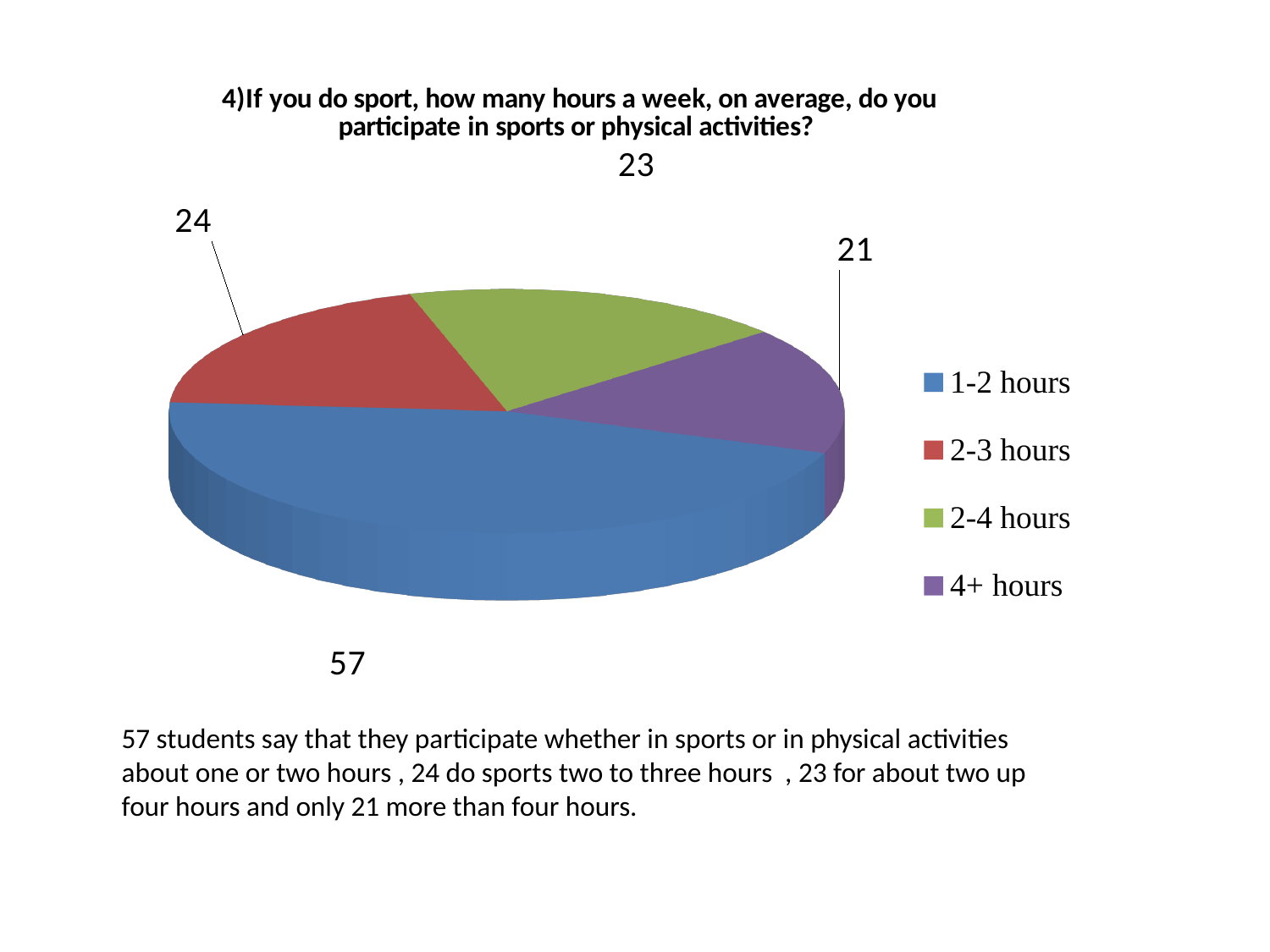
How many categories does the pie chart have? 4 Which category has the smallest slice of the pie? 4+ hours What is the value for the 2-4 hours slice? 23 What is the value for the 2-3 hours slice? 24 How many students participate in sports for 1-2 hours a week? 57 What is the difference between the 1-2 hours value and the 4+ hours value? 36 Which category has the largest slice of the pie? 1-2 hours What colour is the 4+ hours slice? purple What kind of chart is shown on the slide? pie chart What is the value for the 4+ hours slice? 21 What share of the pie does the 1-2 hours slice represent? 45.6% Which is larger, the value for 2-3 hours or the value for 2-4 hours? 2-3 hours